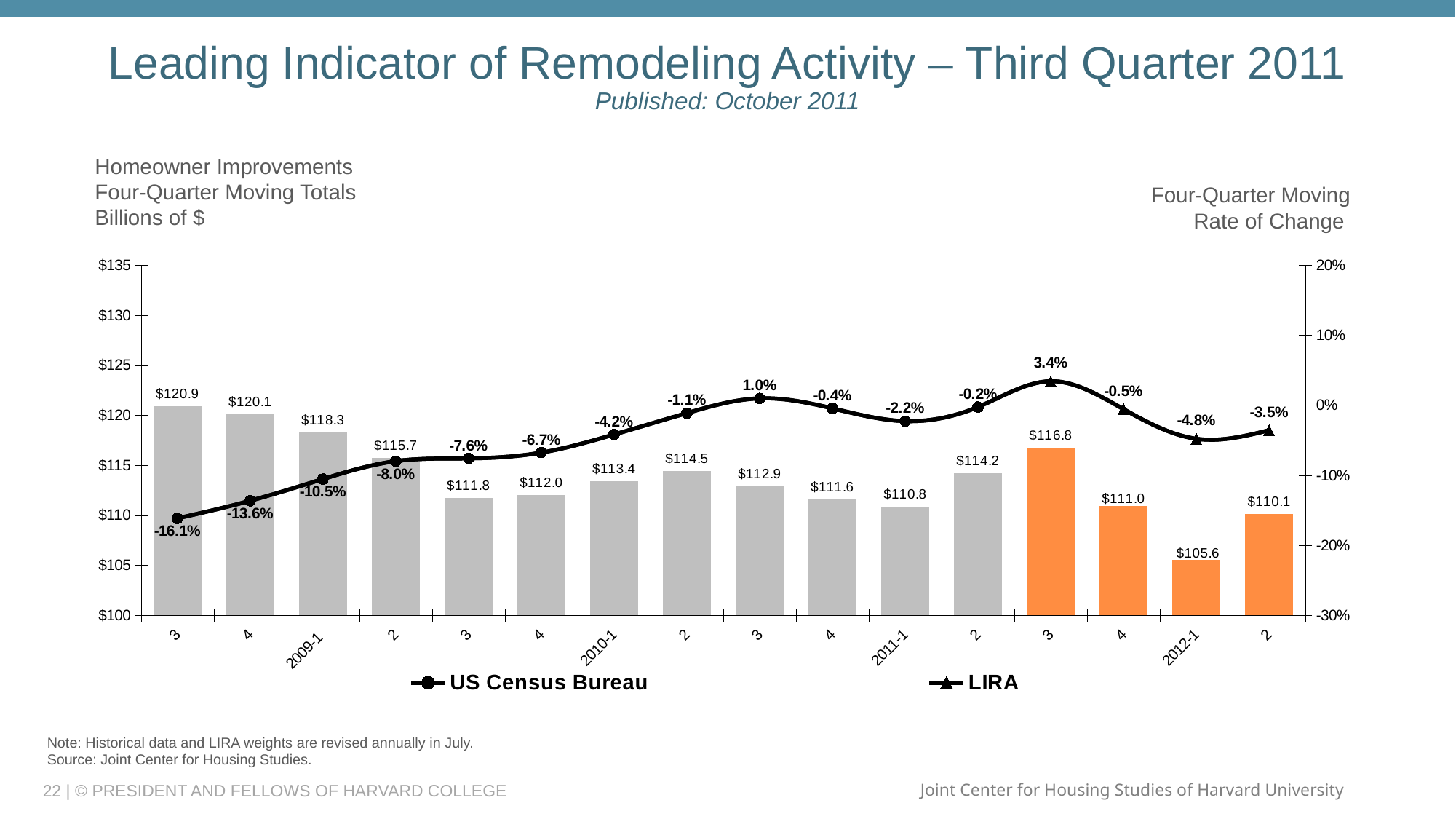
How many series does the legend list? 2 What is the four-quarter moving rate of change shown for the third quarter of 2011 (the point above the $116.8 bar)? 3.4% What is the rate of change shown for 2012-1? -4.8% Which quarter has the lowest four-quarter moving total? 2012-1 What kind of chart is this? Combination bar and line chart How many bars are plotted on the chart? 16 What is the difference between the four-quarter moving totals for 2011-3 ($116.8) and 2011-2 ($114.2)? $2.6 Is the four-quarter moving total for 2012-1 greater or less than $110? less What is the four-quarter moving total for 2009-1? $118.3 Does the rate-of-change line rise or fall from the first point (-16.1%) to the 2010-3 point (1.0%)? rise What is the highest four-quarter moving total shown by any bar? $120.9 Which is larger, the four-quarter moving total for 2010-2 or for 2010-3? 2010-2